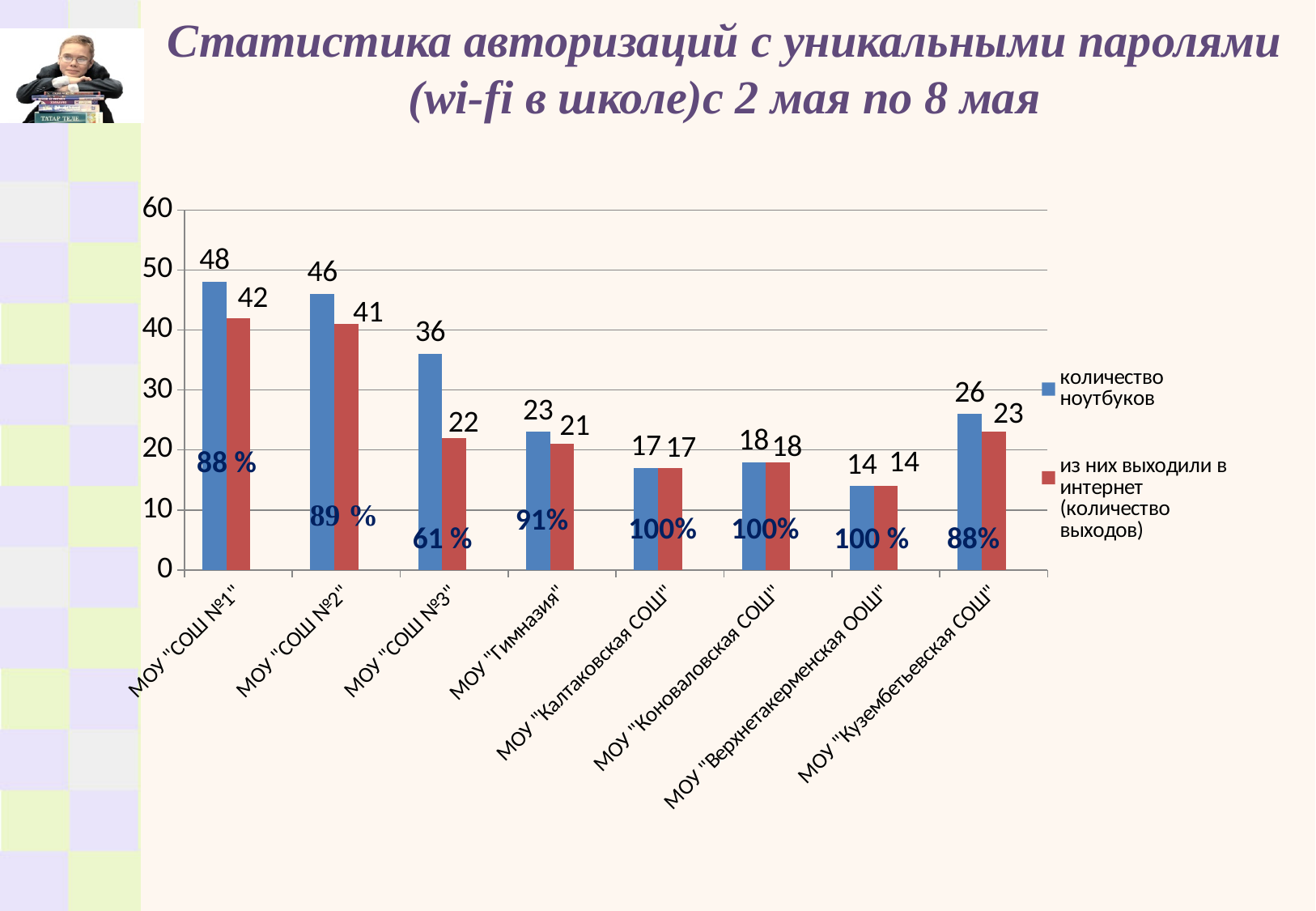
Which category has the lowest value for "количество ноутбуков"? МОУ "Верхнетакерменская ООШ" What is the difference between "количество ноутбуков" and "из них выходили в интернет (количество выходов)" for МОУ "СОШ №3"? 14 What percentage label is shown for МОУ "Гимназия"? 91% Which category has the highest value for "количество ноутбуков"? МОУ "СОШ №1" What kind of chart is shown on the slide? bar chart Is the value of "количество ноутбуков" for МОУ "СОШ №2" greater or less than 40? greater What is the value of "из них выходили в интернет (количество выходов)" for МОУ "Кузембетьевская СОШ"? 23 How many series does the legend list? 2 Which is larger: "количество ноутбуков" for МОУ "СОШ №2" or for МОУ "Гимназия"? МОУ "СОШ №2" What is the value of "количество ноутбуков" for МОУ "СОШ №1"? 48 How many categories are shown on the x axis of the chart? 8 What is the value of "из них выходили в интернет (количество выходов)" for МОУ "СОШ №3"? 22